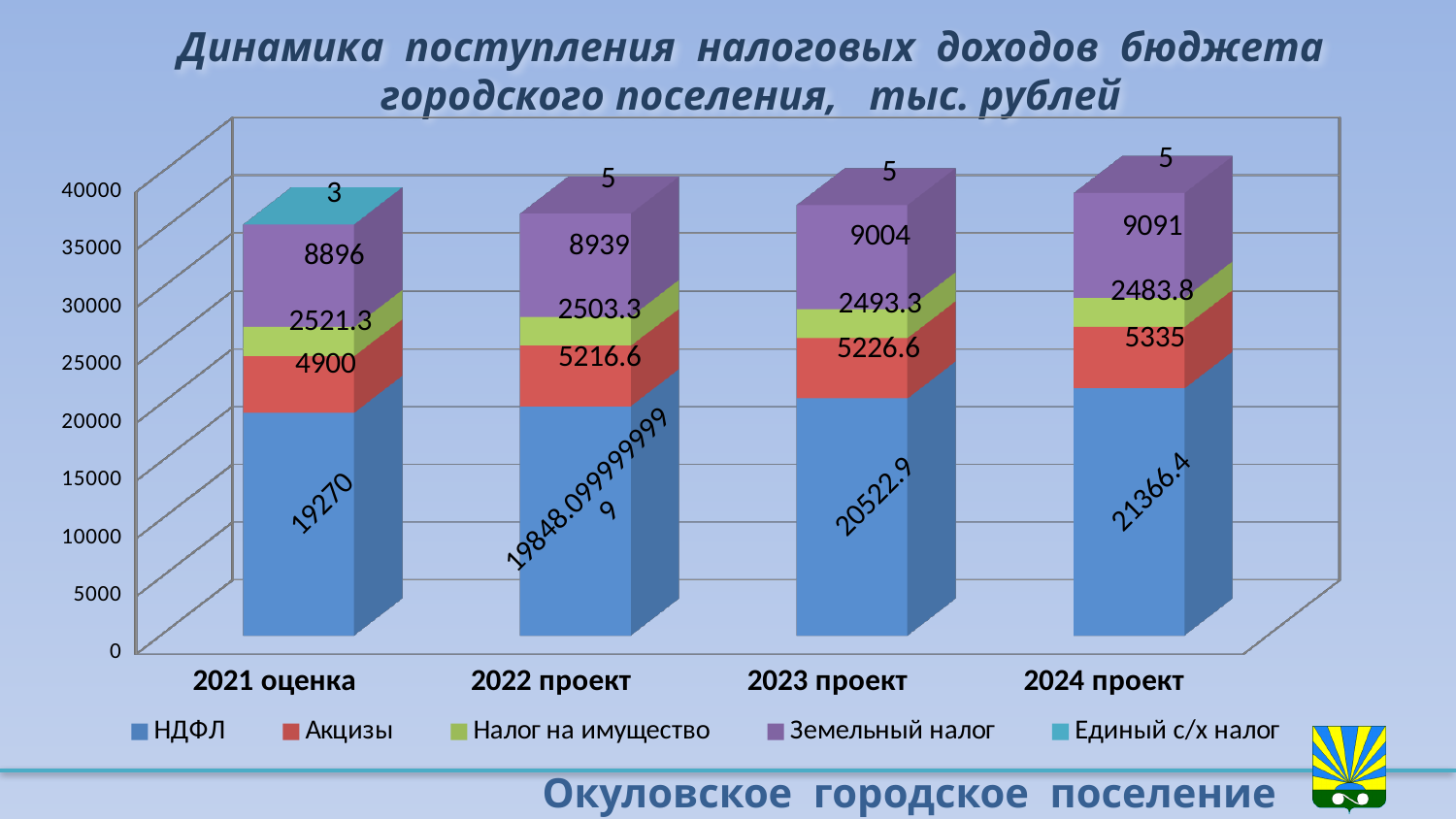
What is the value of НДФЛ for 2021 оценка? 19270 What is the value of Земельный налог for 2024 проект? 9091 What is the difference between Земельный налог for 2024 проект and 2021 оценка? 195 Which category has the highest value of НДФЛ? 2024 проект Which category has the lowest value of Налог на имущество? 2024 проект How many series does the legend list? 5 What is the total of the stacked bar for 2021 оценка? 35590.3 What is the value of Акцизы for 2023 проект? 5226.6 What is the value of Налог на имущество for 2022 проект? 2503.3 What kind of chart is shown on the slide? stacked bar chart Does the value of НДФЛ rise or fall from 2021 оценка to 2024 проект? rise How many categories are shown on the x axis? 4